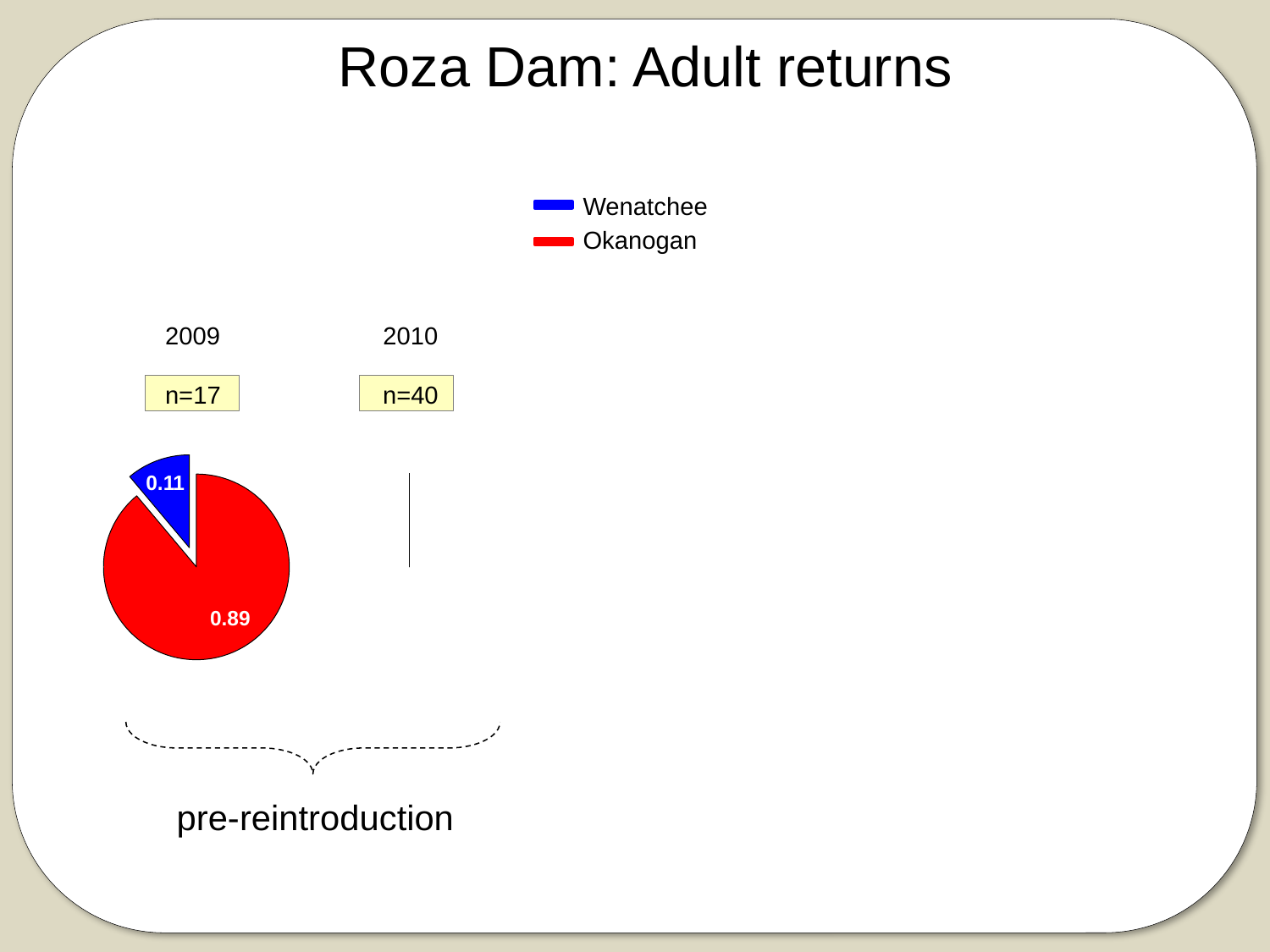
In the 2009 pie chart, which category has the smallest slice? Wenatchee Which colour represents Wenatchee in the legend? Blue In the 2009 pie chart, what is the difference between the Okanogan and Wenatchee values? 0.78 How many series does the legend list? 2 What sample size (n) is shown above the 2009 pie chart? n=17 In the 2009 pie chart, which category has the largest slice? Okanogan In the 2009 pie chart, which is larger: Wenatchee or Okanogan? Okanogan In the 2009 pie chart, what is the value shown for Okanogan? 0.89 In the 2009 pie chart, what is the value shown for Wenatchee? 0.11 How many slices does the 2009 pie chart have? 2 What type of chart is shown for 2009? Pie chart